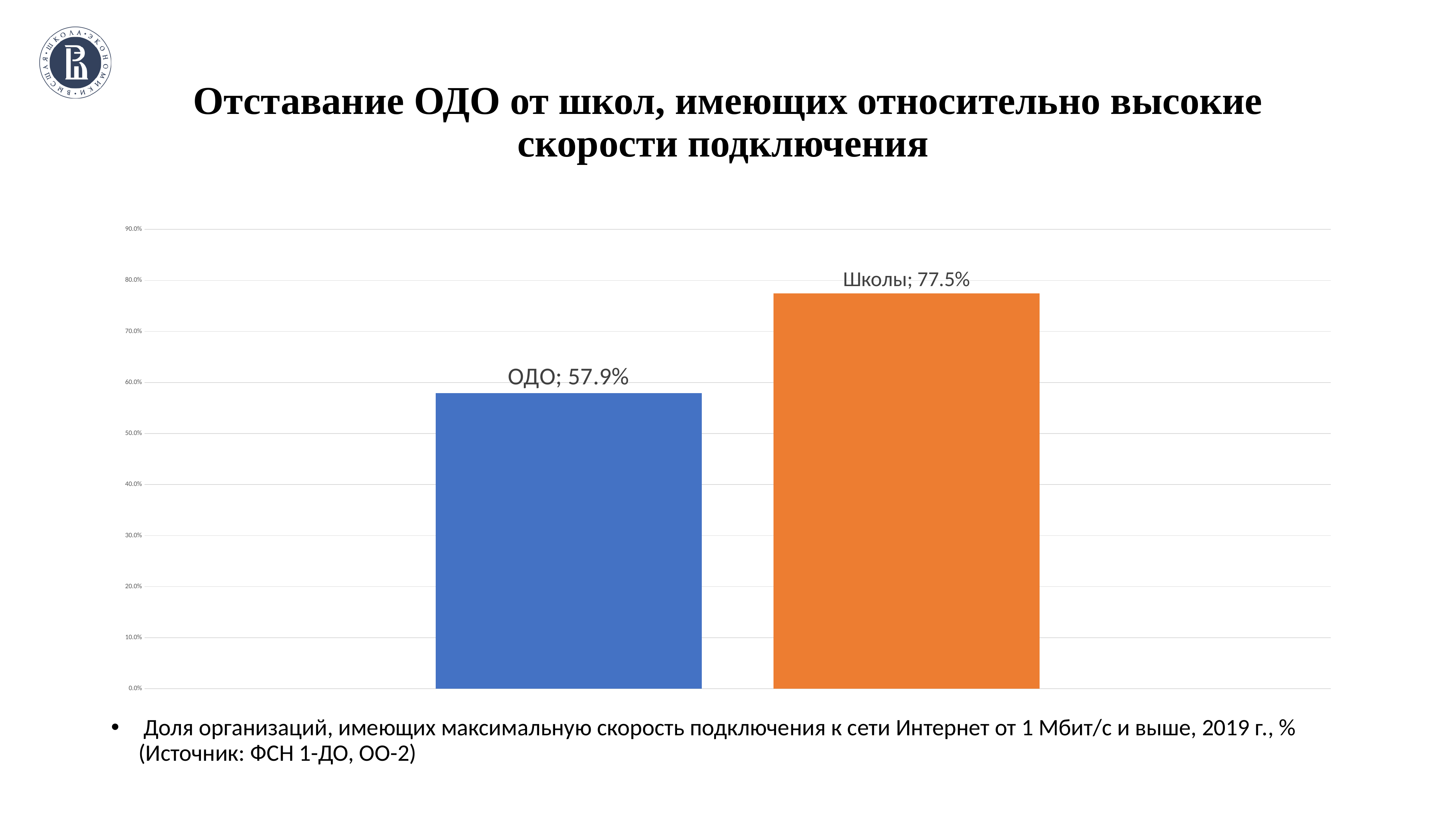
What is the value for Школы? 77.5% Which is larger, the value for ОДО or the value for Школы? Школы Is the value for ОДО greater or less than 60.0%? less Which category has the lowest value? ОДО How many categories are shown in the chart? 2 Which category has the highest value? Школы What colour is the bar for Школы? orange What is the value for ОДО? 57.9% What is the difference between the values for Школы and ОДО? 19.6% What is the highest value shown on the vertical axis? 90.0% What kind of chart is shown on the slide? bar chart Is the value for Школы greater or less than 70.0%? greater